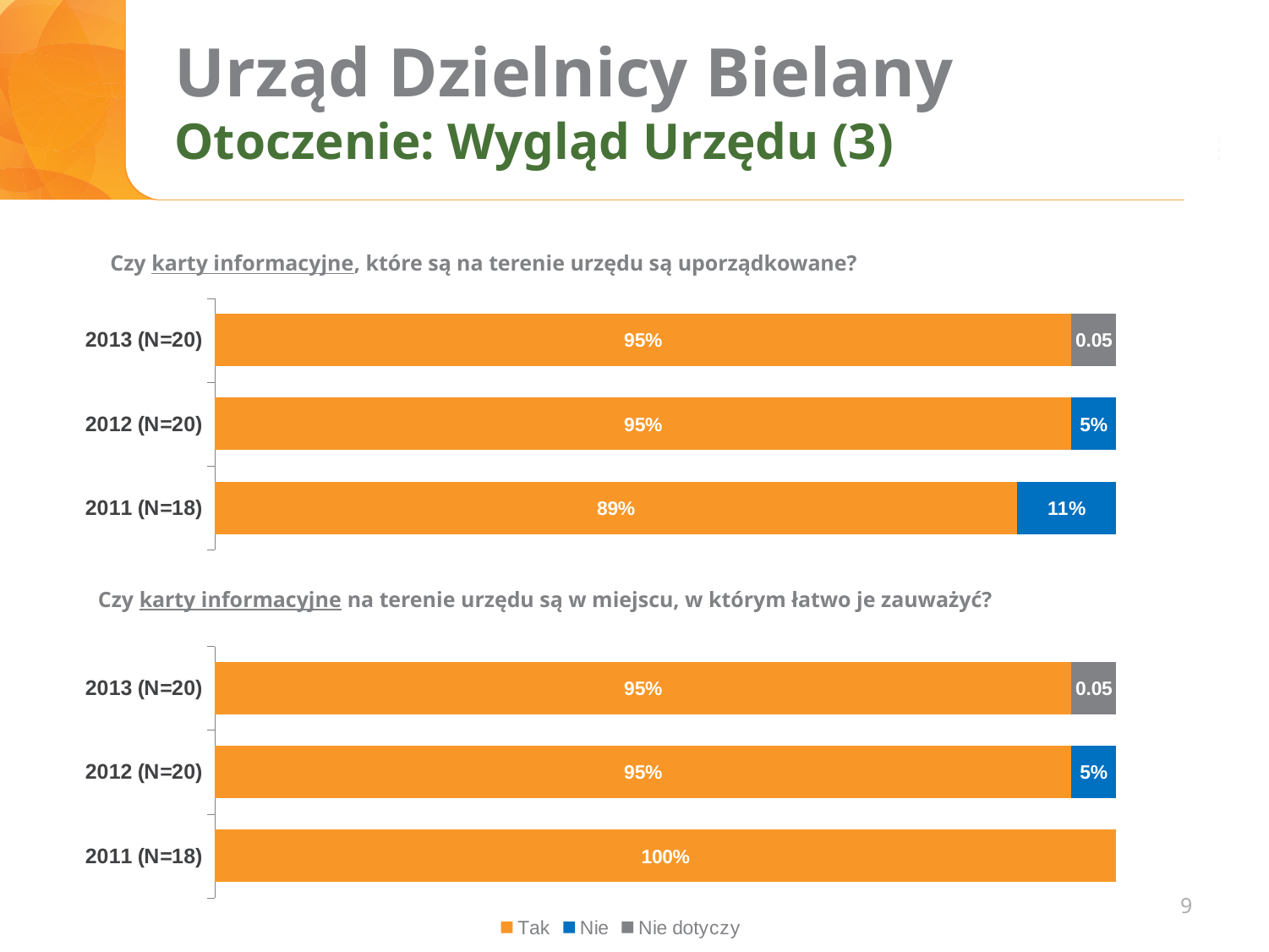
In the top chart ("Czy karty informacyjne, które są na terenie urzędu są uporządkowane?"), what is the Nie value for 2011 (N=18)? 11% In the top chart ("Czy karty informacyjne, które są na terenie urzędu są uporządkowane?"), which year has the lowest Tak value? 2011 (N=18) In the top chart ("Czy karty informacyjne, które są na terenie urzędu są uporządkowane?"), what is the Nie value for 2012 (N=20)? 5% In the bottom chart ("Czy karty informacyjne na terenie urzędu są w miejscu, w którym łatwo je zauważyć?"), what is the Tak value for 2013 (N=20)? 95% How many year categories does the top chart ("Czy karty informacyjne, które są na terenie urzędu są uporządkowane?") show? 3 In the bottom chart ("Czy karty informacyjne na terenie urzędu są w miejscu, w którym łatwo je zauważyć?"), is the Tak value for 2011 (N=18) larger or smaller than for 2012 (N=20)? larger In the top chart ("Czy karty informacyjne, które są na terenie urzędu są uporządkowane?"), what is the difference between the Tak values for 2012 (N=20) and 2011 (N=18)? 6% In the bottom chart ("Czy karty informacyjne na terenie urzędu są w miejscu, w którym łatwo je zauważyć?"), which year has the highest Tak value? 2011 (N=18) In the top chart ("Czy karty informacyjne, które są na terenie urzędu są uporządkowane?"), what is the Tak value for 2011 (N=18)? 89% What type of chart is the bottom chart ("Czy karty informacyjne na terenie urzędu są w miejscu, w którym łatwo je zauważyć?")? Stacked bar chart How many series does the legend at the bottom of the slide list? 3 In the bottom chart ("Czy karty informacyjne na terenie urzędu są w miejscu, w którym łatwo je zauważyć?"), what is the Tak value for 2011 (N=18)? 100%